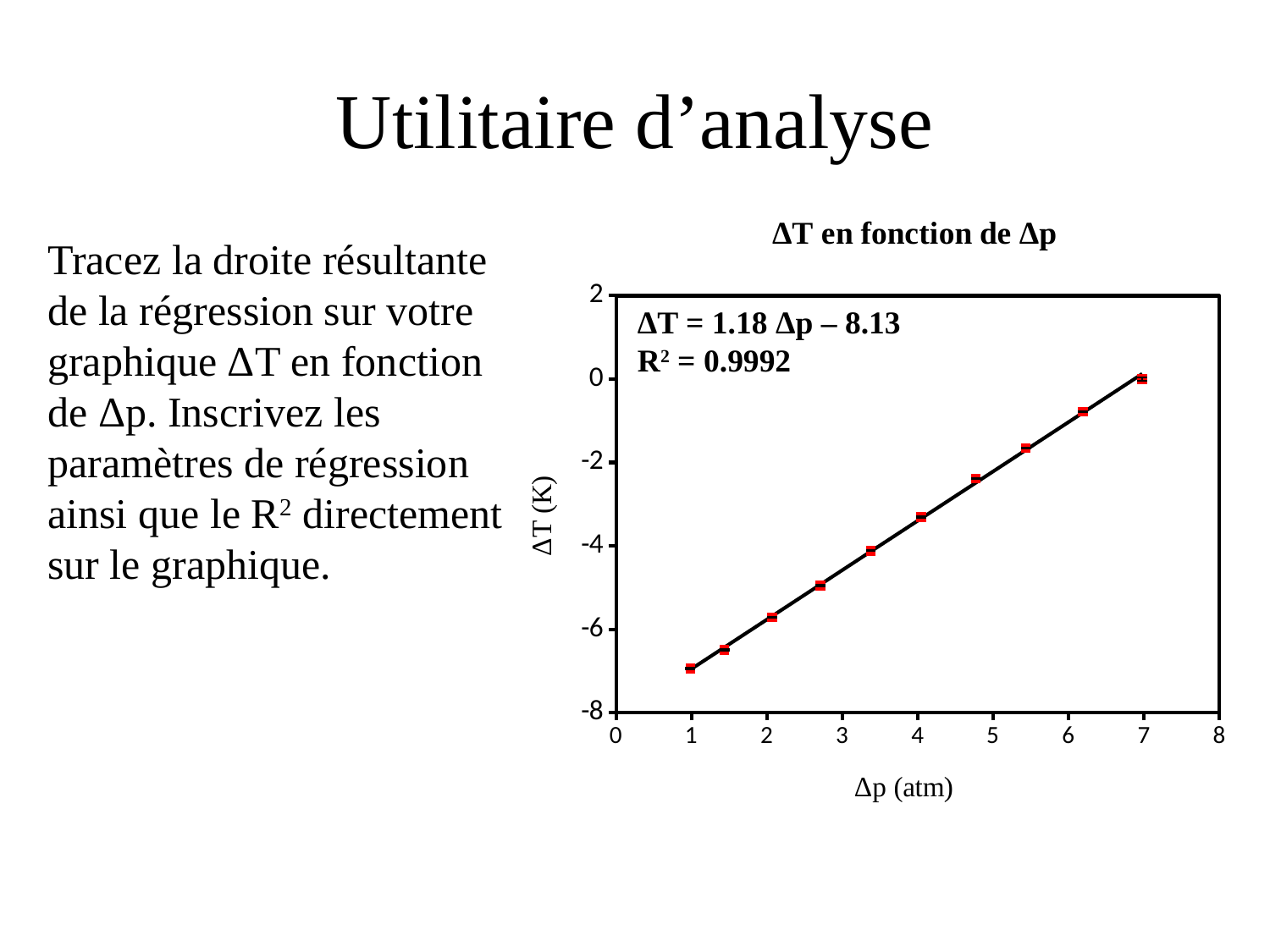
Do the ΔT values rise or fall as Δp increases along the x axis? rise What R² value is printed on the chart? 0.9992 Is the ΔT value for the data point at Δp ≈ 1 atm greater or less than -6? less How many data points are plotted on the chart? 10 Is the ΔT value for the data point at Δp ≈ 2.7 atm greater or less than -4? less What is the label of the x axis? Δp (atm) What is the title of the chart? ΔT en fonction de Δp Is the ΔT value for the data point at Δp ≈ 4 atm greater or less than -4? greater Which data point has the larger ΔT value, the leftmost point or the rightmost point? the rightmost point What kind of chart is shown on the slide? scatter chart